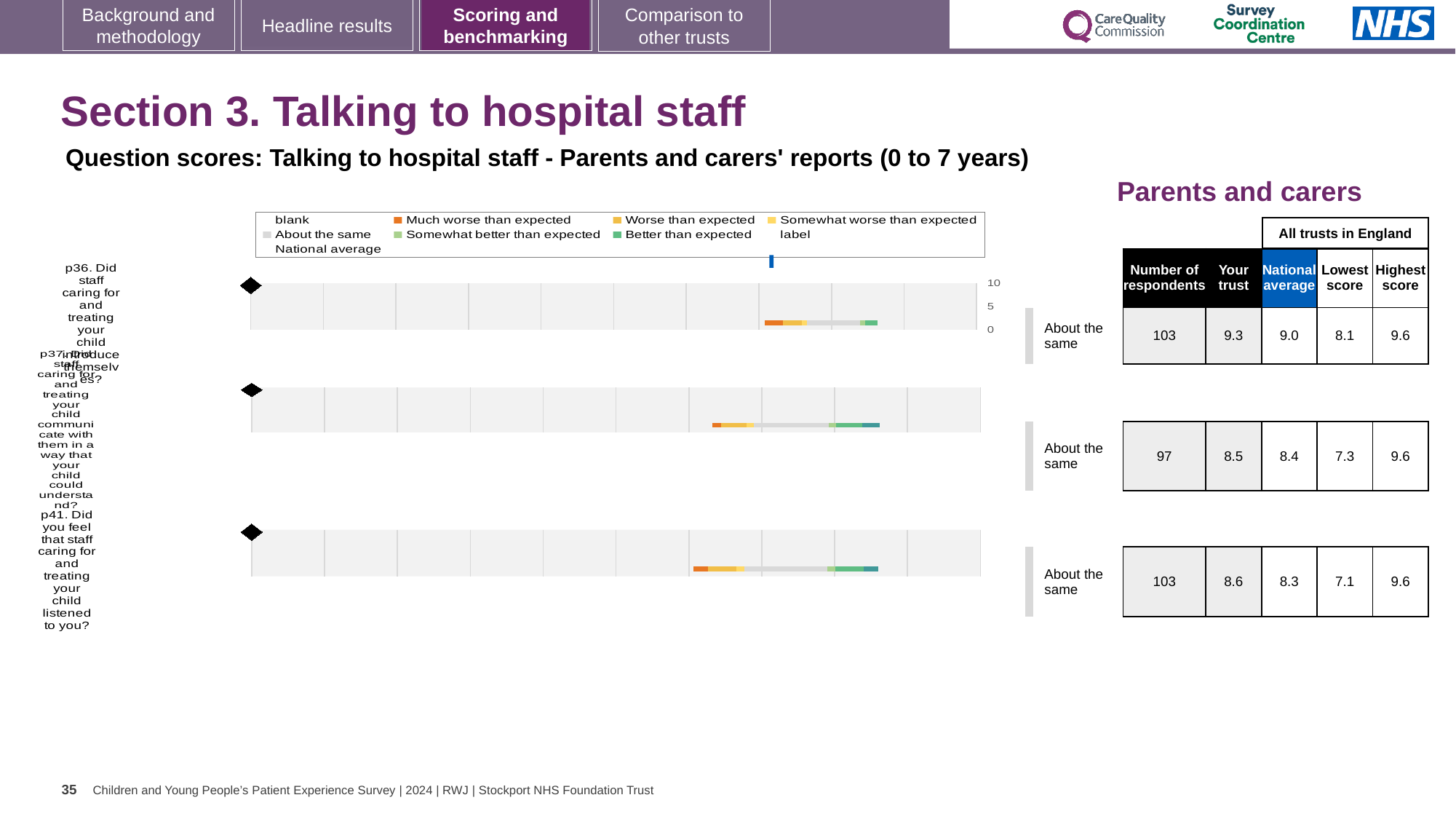
What is the lowest score among all trusts in England for p41 (Did you feel that staff listened to you?)? 7.1 What is the highest value shown on the chart's score axis? 10 Which survey question has the highest 'Your trust' score? p36 What is the 'Your trust' score for p36 (Did staff caring for and treating your child introduce themselves?)? 9.3 For p41, which is larger: the 'Your trust' score or the national average? Your trust How many survey questions (bars) are plotted in the chart? 3 Which survey question has the lowest 'Lowest score' across all trusts in England? p41 What benchmark category is shown for p37? About the same What kind of chart is shown on the slide? bar chart What is the difference between the 'Your trust' score and the national average for p36? 0.3 What is the national average score for p37 (Did staff communicate with your child in a way they could understand?)? 8.4 How many respondents answered p37? 97